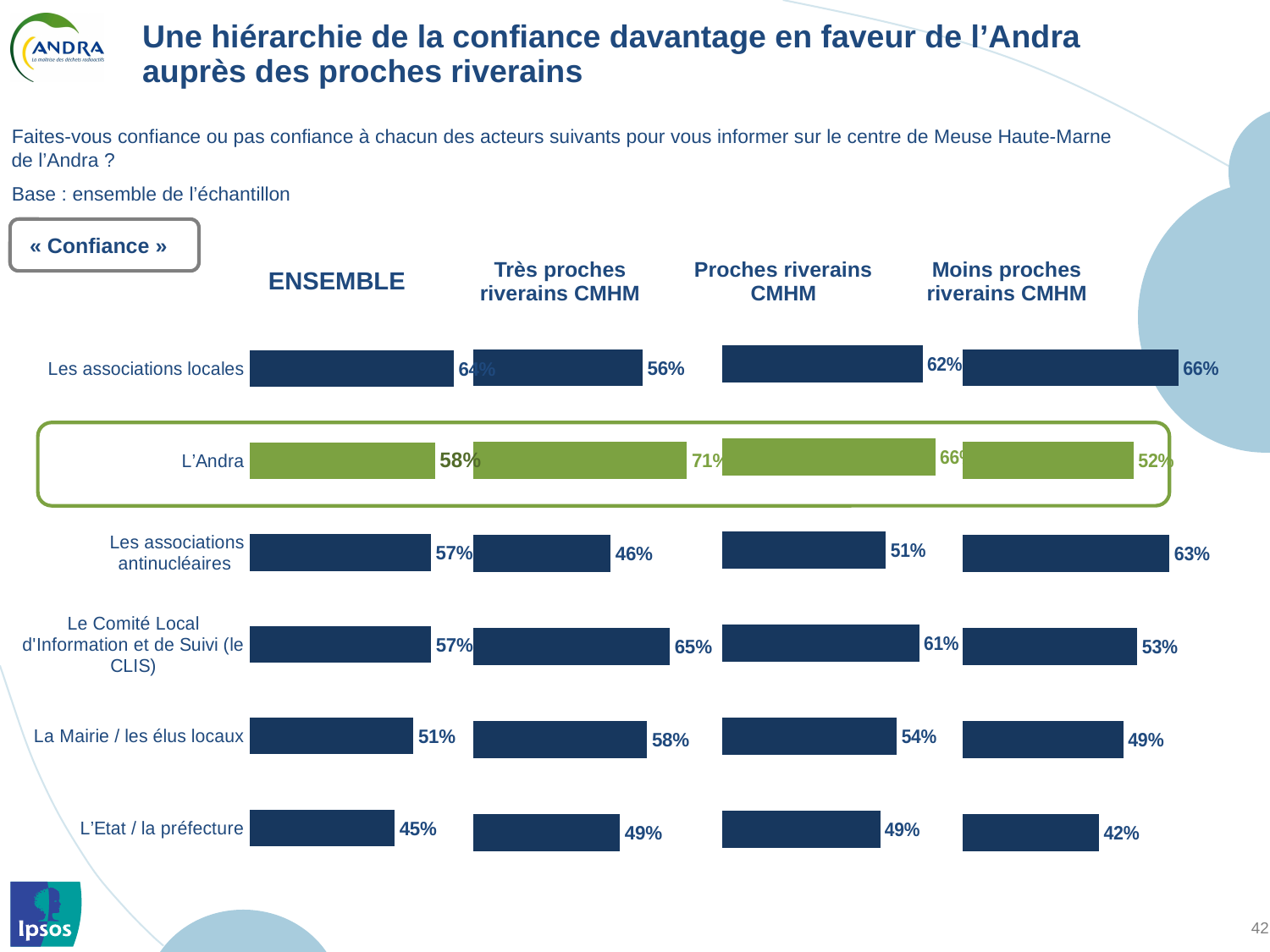
In the 'Très proches riverains CMHM' chart, what is the difference between the value for L'Andra and the value for Les associations antinucléaires? 25 percentage points In the 'Très proches riverains CMHM' chart, what is the value for L'Andra? 71% In the 'Moins proches riverains CMHM' chart, what is the value for L'Etat / la préfecture? 42% In the 'Proches riverains CMHM' chart, what is the value for La Mairie / les élus locaux? 54% How many categories (actors) are shown in the 'ENSEMBLE' chart? 6 Which category's bars are highlighted in green across the charts? L'Andra In the 'Très proches riverains CMHM' chart, which category has the lowest value? Les associations antinucléaires In the 'ENSEMBLE' chart, what is the value for L'Etat / la préfecture? 45% In the 'ENSEMBLE' chart, which category has the lowest value? L'Etat / la préfecture In the 'Moins proches riverains CMHM' chart, which category has the highest value? Les associations locales What type of chart is used on this slide? Bar chart In the 'Proches riverains CMHM' chart, which is larger: the value for Les associations locales or the value for Les associations antinucléaires? Les associations locales